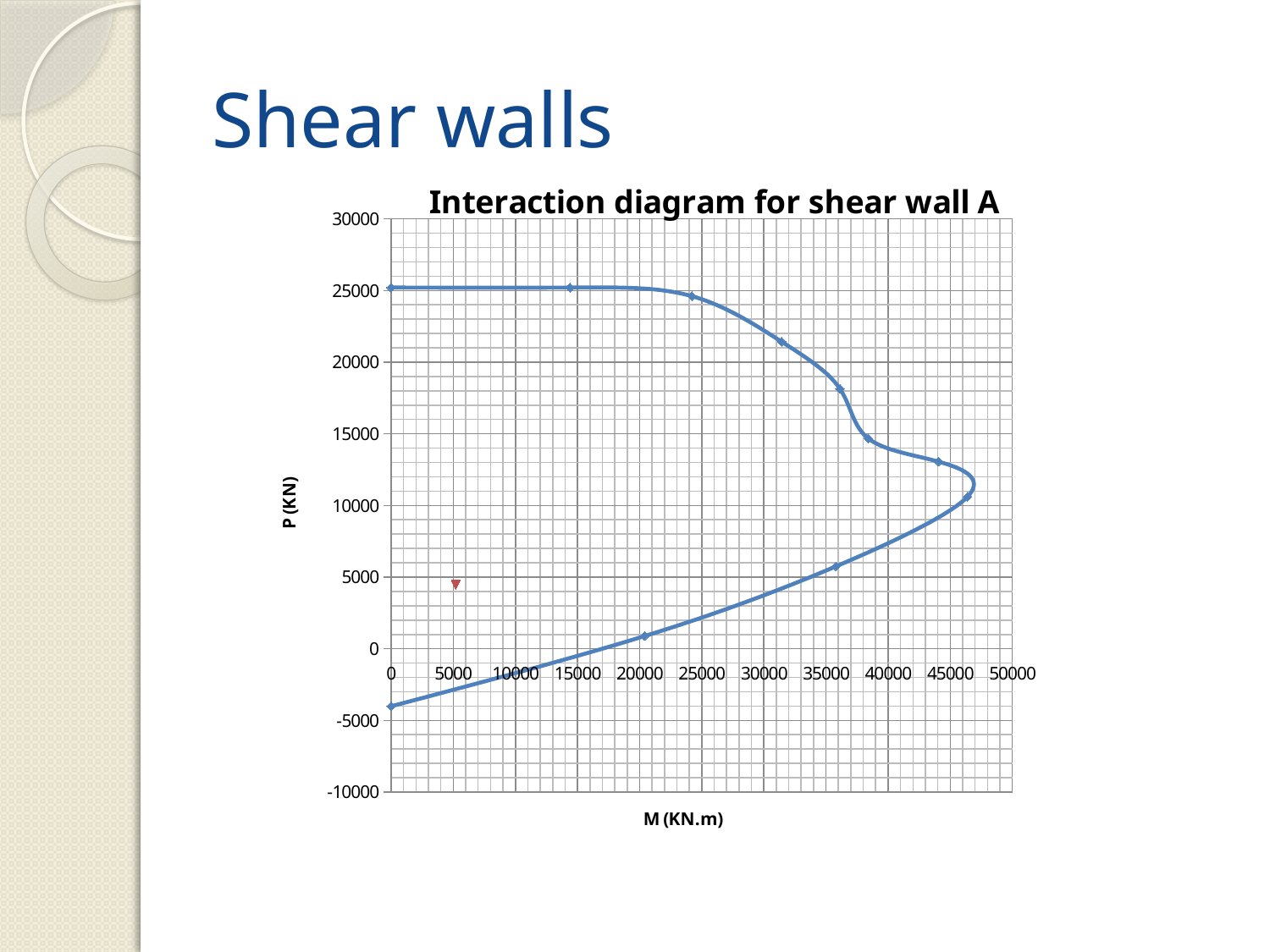
Is the lowest P value on the blue curve greater or less than -5000? greater What kind of chart is shown on the slide? Line chart (scatter with smoothed line) What is the maximum value shown on the horizontal (M) axis? 50000 Is the largest M value reached by the blue curve greater or less than 50000? less How many diamond markers are plotted on the blue curve? 11 Is the largest M value reached by the blue curve greater or less than 45000? greater What is the label of the vertical axis? P (KN) What is the title of the chart? Interaction diagram for shear wall A